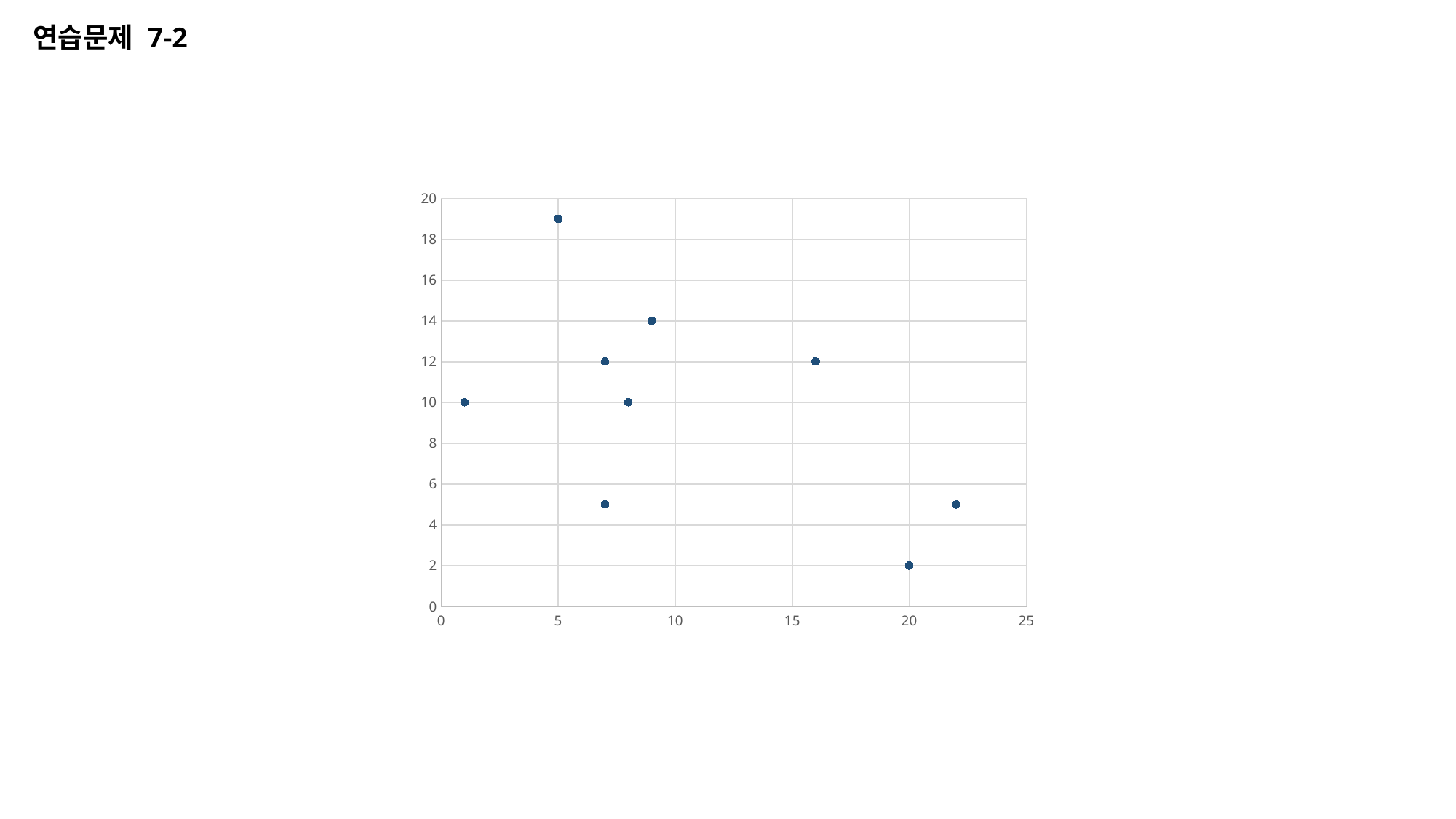
Is the y value of the point at x = 22 greater or less than 6? less At which x value is the point with the lowest y value located? 20 How many data points are plotted on the chart? 9 Is the y value of the point at x = 5 greater or less than 18? greater At which x value is the point with the highest y value located? 5 What is the y value of the point plotted at x = 20? 2 Which point has a larger y value: the point at x = 9 or the point at x = 22? the point at x = 9 What kind of chart is shown on the slide? scatter chart How many points are plotted with an x value greater than 15? 3 Is the y value of the point at x = 16 greater or less than 10? greater What is the maximum value shown on the y axis? 20 What is the maximum value shown on the x axis? 25